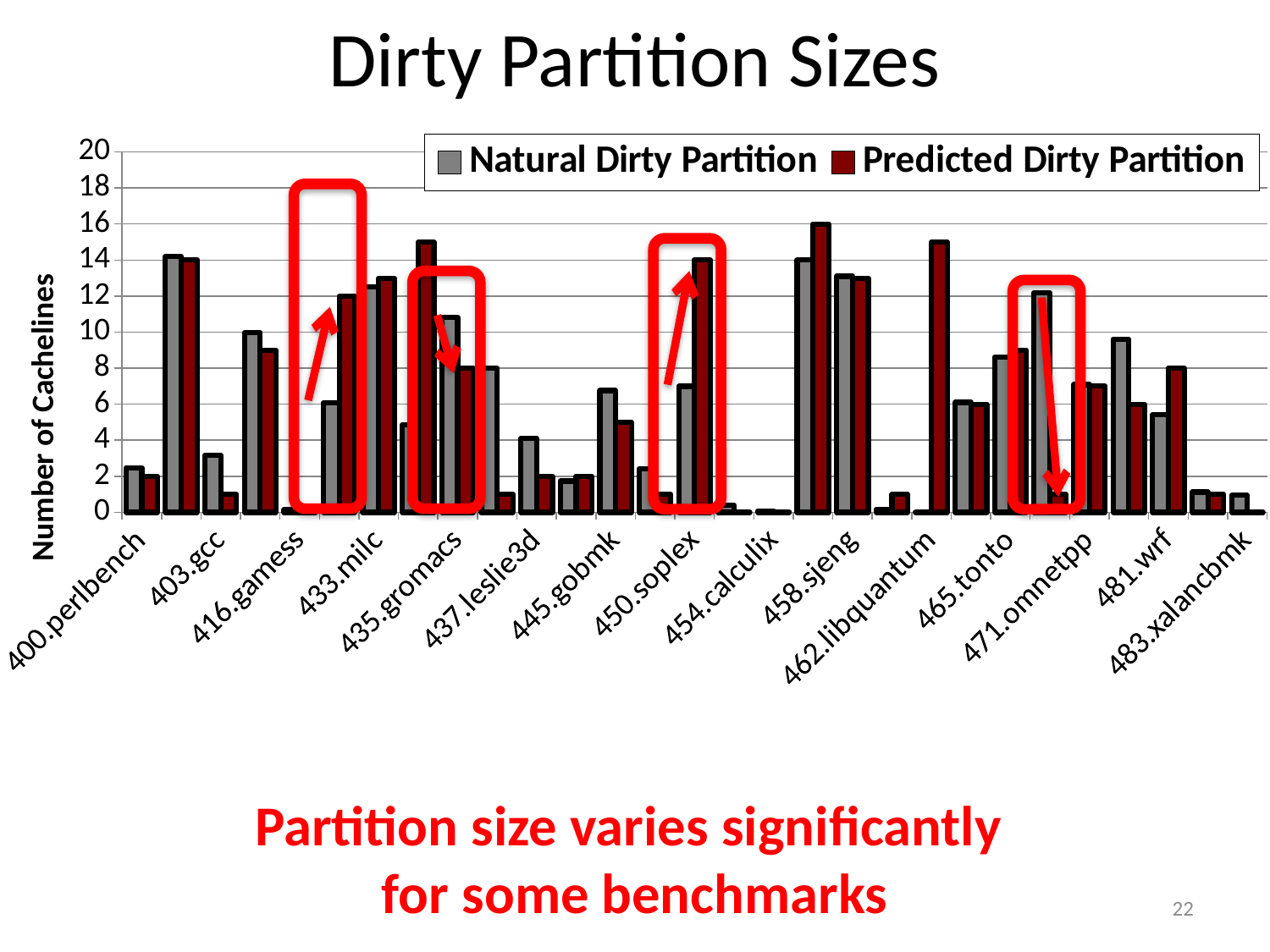
Is the Predicted Dirty Partition value for 450.soplex greater or less than 10? greater Is the Natural Dirty Partition value for 400.perlbench greater or less than 4? less Is the Natural Dirty Partition value for 450.soplex greater or less than 10? less What is the label of the vertical axis? Number of Cachelines For 435.gromacs, which is larger: the Natural Dirty Partition or the Predicted Dirty Partition? Natural Dirty Partition What kind of chart is shown on the slide? bar chart For 450.soplex, which is larger: the Natural Dirty Partition or the Predicted Dirty Partition? Predicted Dirty Partition What are the two series named in the legend? Natural Dirty Partition and Predicted Dirty Partition How many series does the legend list? 2 For 462.libquantum, which is larger: the Natural Dirty Partition or the Predicted Dirty Partition? Predicted Dirty Partition